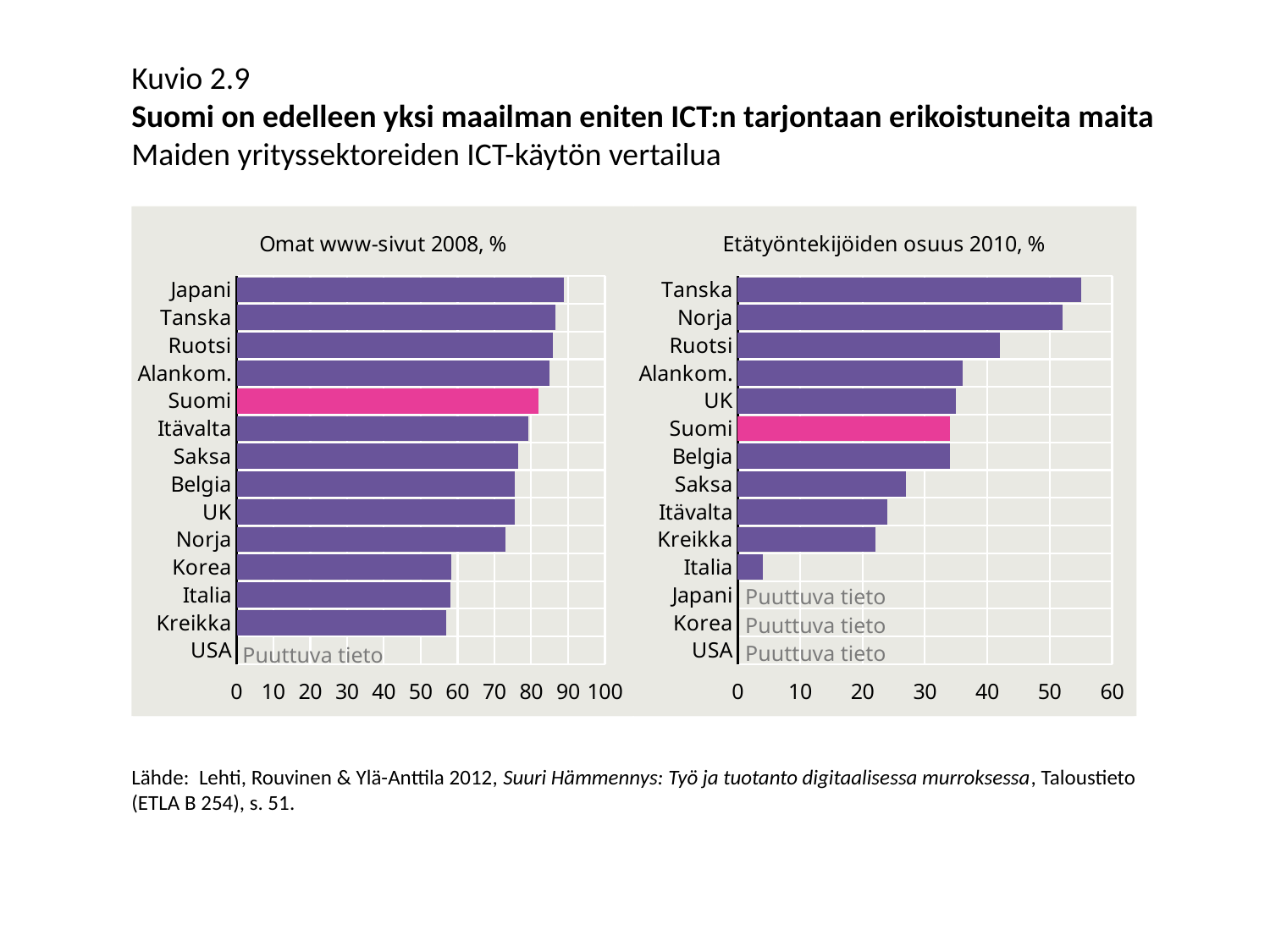
In the right chart 'Etätyöntekijöiden osuus 2010, %', is the value for Italia greater or less than 10? less In the right chart 'Etätyöntekijöiden osuus 2010, %', which country's bar is highlighted in pink? Suomi In the right chart 'Etätyöntekijöiden osuus 2010, %', is the value for Kreikka greater or less than 30? less In the left chart 'Omat www-sivut 2008, %', is the value for Korea greater or less than 70? less What kind of chart is the left chart, 'Omat www-sivut 2008, %'? bar chart In the right chart 'Etätyöntekijöiden osuus 2010, %', how many countries are marked 'Puuttuva tieto' (missing data)? 3 In the right chart 'Etätyöntekijöiden osuus 2010, %', which country has the highest value? Tanska In the left chart 'Omat www-sivut 2008, %', which is larger, the value for Japani or the value for Korea? Japani In the right chart 'Etätyöntekijöiden osuus 2010, %', which country with a plotted bar has the lowest value? Italia In the left chart 'Omat www-sivut 2008, %', which country has the highest value? Japani